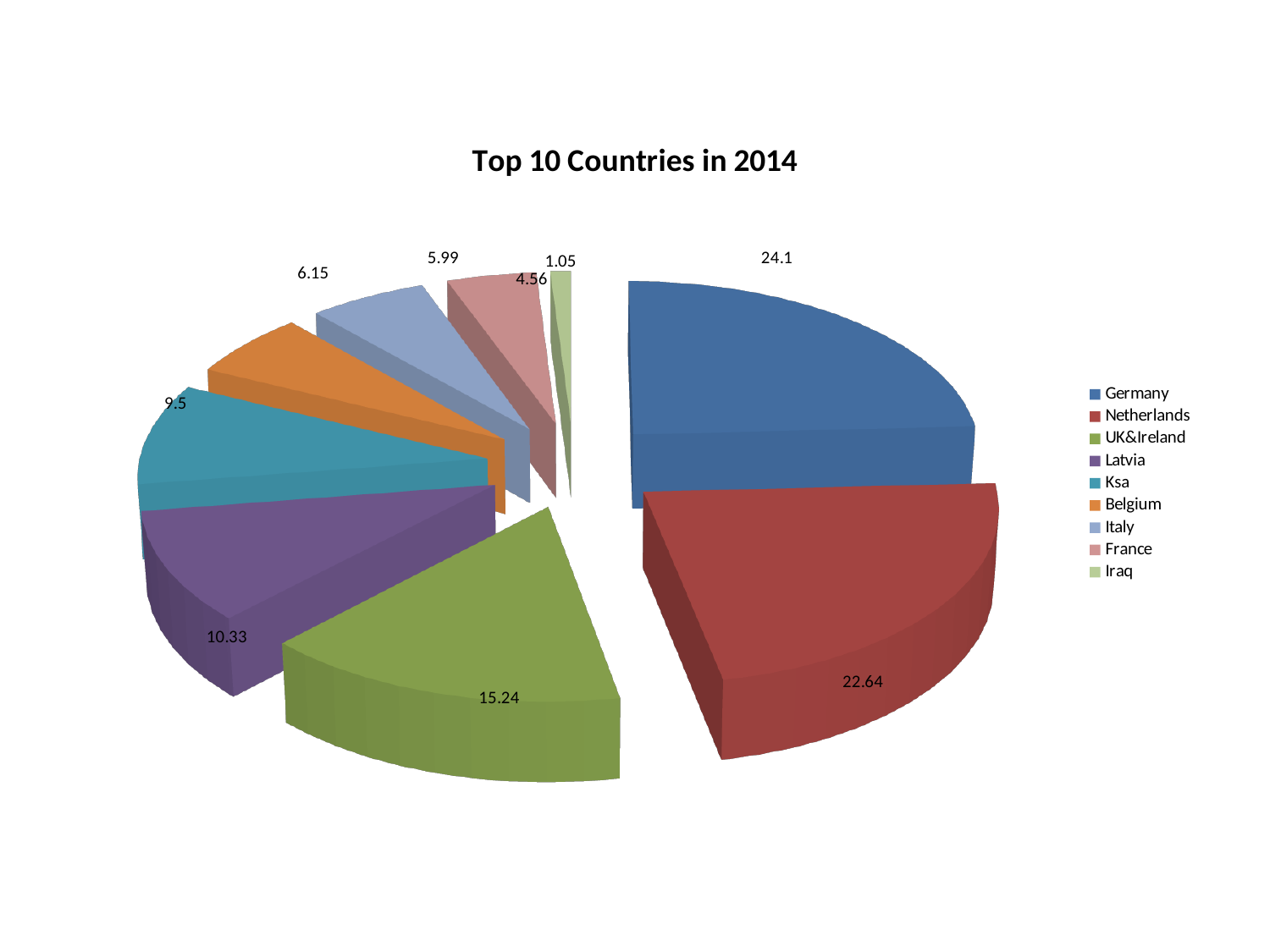
What value is shown for Latvia? 10.33 What value is shown for France? 4.56 How many countries are listed in the legend? 9 What is the difference between the values for UK&Ireland and Latvia? 4.91 What is the title of the chart? Top 10 Countries in 2014 What value is shown for Iraq? 1.05 Which country has the smallest slice of the pie? Iraq What type of chart is shown on the slide? Pie chart Which is larger, the value for Ksa or the value for Belgium? Ksa What value is shown for Netherlands? 22.64 What value is shown for Germany? 24.1 Which country has the largest slice of the pie? Germany